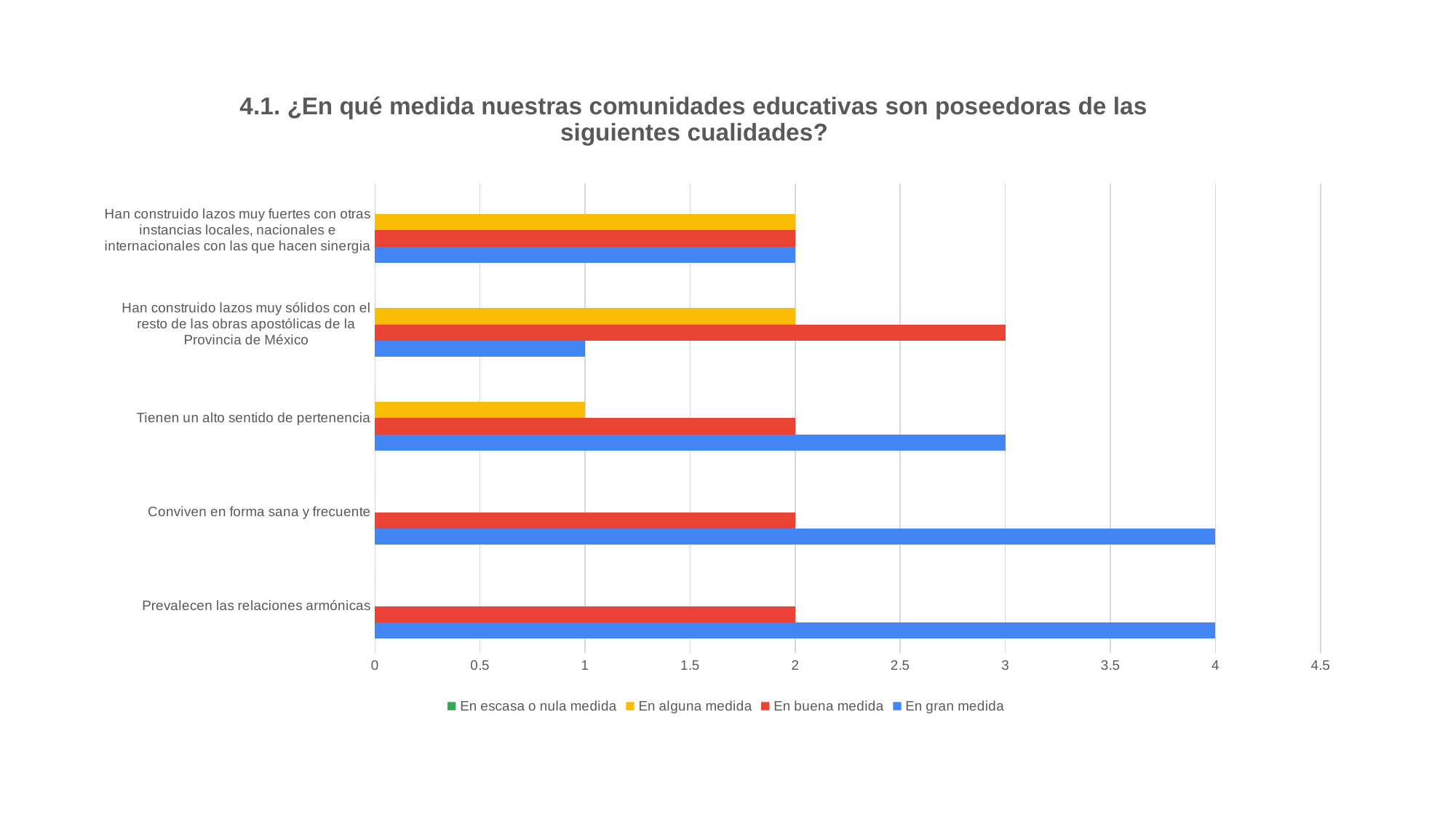
What is the title of the chart? 4.1. ¿En qué medida nuestras comunidades educativas son poseedoras de las siguientes cualidades? How many categories are shown on the vertical axis? 5 How many series does the legend list? 4 Which category has the lowest value for "En gran medida"? Han construido lazos muy sólidos con el resto de las obras apostólicas de la Provincia de México What is the difference between the "En gran medida" values for "Prevalecen las relaciones armónicas" and "Tienen un alto sentido de pertenencia"? 1 What kind of chart is shown on the slide? Bar chart What is the value of "En alguna medida" for "Tienen un alto sentido de pertenencia"? 1 Which category has the highest value for "En buena medida"? Han construido lazos muy sólidos con el resto de las obras apostólicas de la Provincia de México What is the value of "En buena medida" for "Han construido lazos muy sólidos con el resto de las obras apostólicas de la Provincia de México"? 3 For "Tienen un alto sentido de pertenencia", which is larger: "En gran medida" or "En buena medida"? En gran medida What is the value of "En gran medida" for "Han construido lazos muy sólidos con el resto de las obras apostólicas de la Provincia de México"? 1 What is the value of "En gran medida" for "Conviven en forma sana y frecuente"? 4